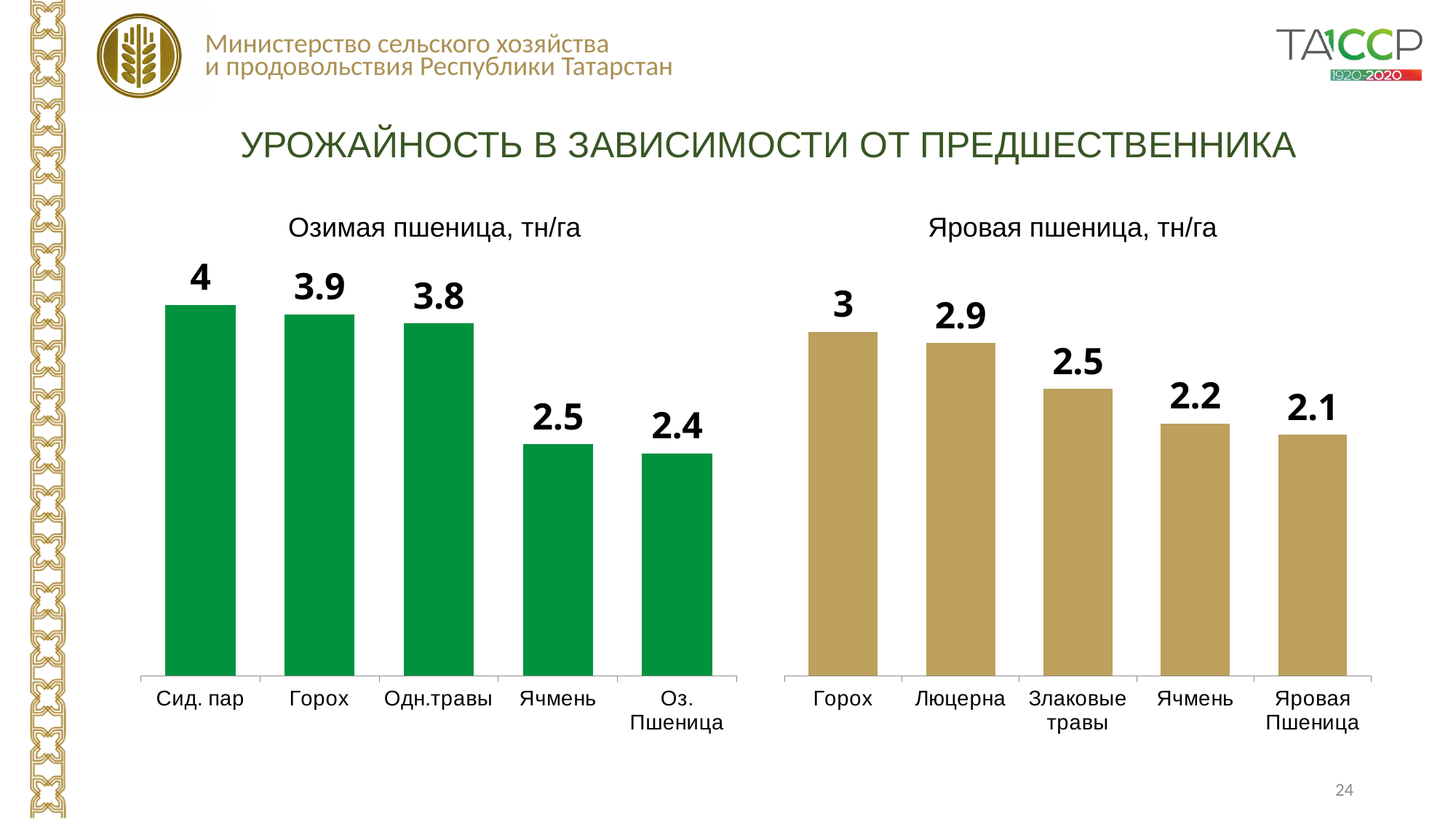
In the 'Яровая пшеница, тн/га' chart, which is larger: the value for Злаковые травы or the value for Ячмень? Злаковые травы In the 'Яровая пшеница, тн/га' chart, what is the difference between the values for Горох and Ячмень? 0.8 In the 'Озимая пшеница, тн/га' chart, which category has the highest value? Сид. пар In the 'Яровая пшеница, тн/га' chart, what is the value for Яровая Пшеница? 2.1 In the 'Озимая пшеница, тн/га' chart, what is the value for Ячмень? 2.5 What kind of chart is the 'Яровая пшеница, тн/га' chart? Bar chart In the 'Озимая пшеница, тн/га' chart, what is the value for Сид. пар? 4 In the 'Яровая пшеница, тн/га' chart, which category has the lowest value? Яровая Пшеница How many categories are shown in the 'Озимая пшеница, тн/га' chart? 5 In the 'Озимая пшеница, тн/га' chart, what is the difference between the values for Сид. пар and Оз. Пшеница? 1.6 In the 'Яровая пшеница, тн/га' chart, what is the value for Люцерна? 2.9 In the 'Яровая пшеница, тн/га' chart, do the values rise or fall from left to right? Fall